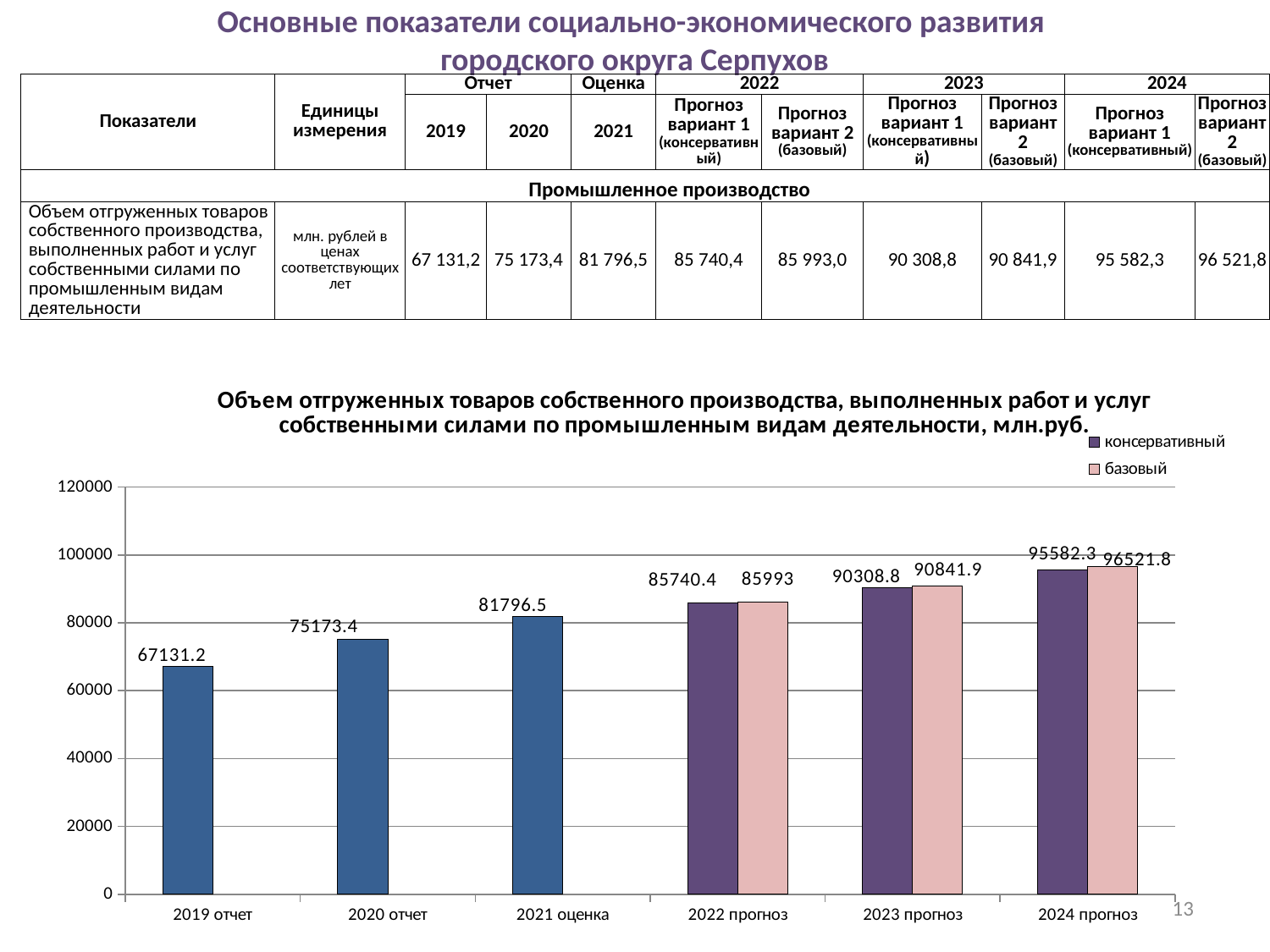
What is the value for 2019 отчет on the chart? 67131.2 Is the value for 2020 отчет greater or less than 80000? less How many categories are shown on the x axis of the chart? 6 Which category has the lowest value on the chart? 2019 отчет What is the консервативный value for 2024 прогноз? 95582.3 What is the базовый value for 2023 прогноз? 90841.9 What is the difference between the базовый and консервативный values for 2024 прогноз? 939.5 Which is larger for 2023 прогноз: the консервативный value or the базовый value? базовый What is the базовый value for 2022 прогноз? 85993 What is the difference between the 2021 оценка value and the 2019 отчет value? 14665.3 Which bar has the highest value on the chart? 2024 прогноз, базовый How many series does the chart legend list? 2